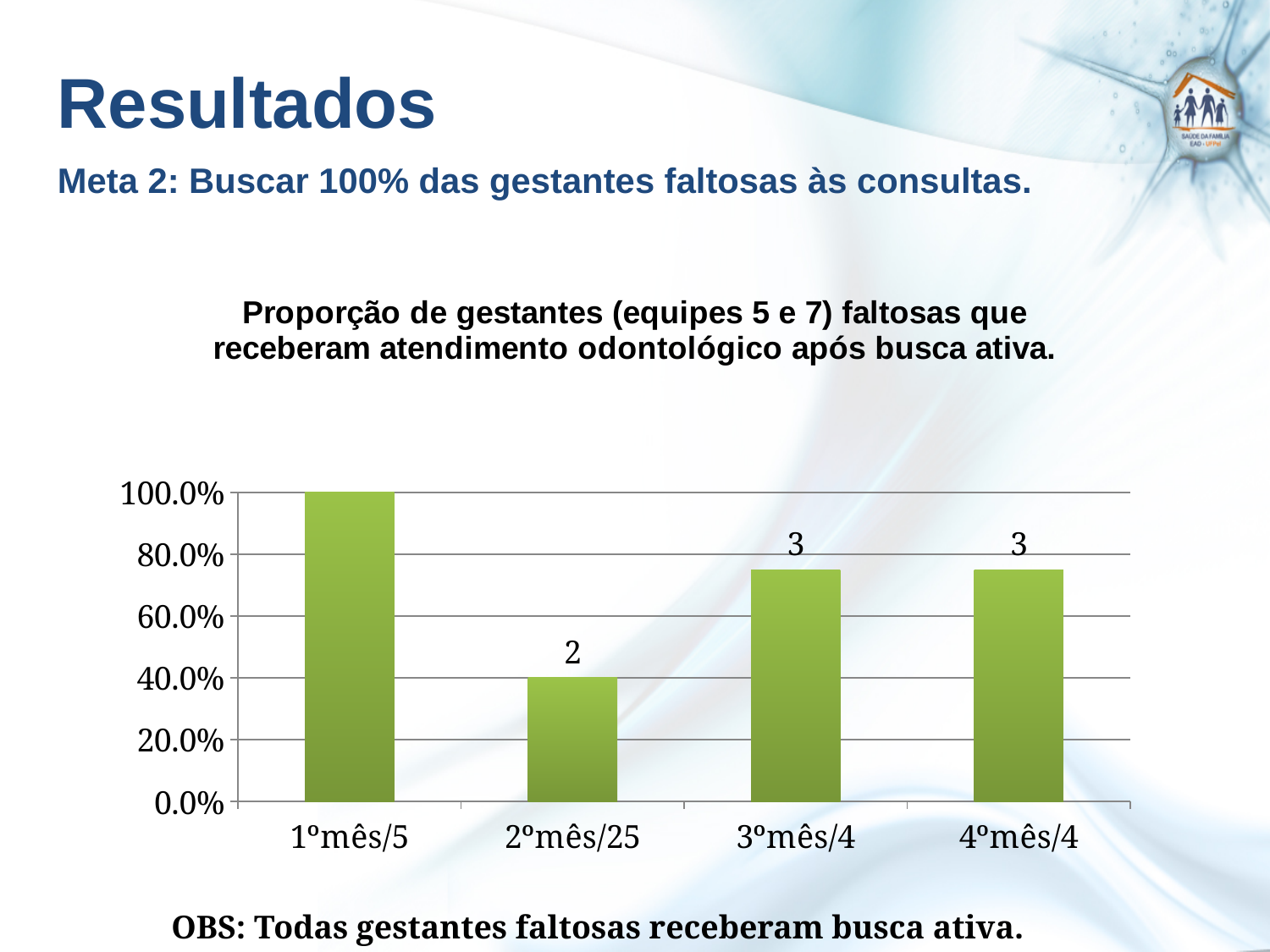
What type of chart is shown on the slide? bar chart Which category has the highest bar in the chart? 1ºmês/5 What value does the bar for 2ºmês/25 reach on the y axis? 40.0% What data label is printed above the bar for 3ºmês/4? 3 Which category has the lowest bar in the chart? 2ºmês/25 Which is larger, the bar for 1ºmês/5 or the bar for 2ºmês/25? 1ºmês/5 What colour are the bars in the chart? green What value does the bar for 1ºmês/5 reach on the y axis? 100.0% What data label is printed above the bar for 2ºmês/25? 2 Is the value for 3ºmês/4 greater or less than 60.0%? greater How many categories are shown on the x axis of the chart? 4 Is the value for 4ºmês/4 greater or less than 80.0%? less